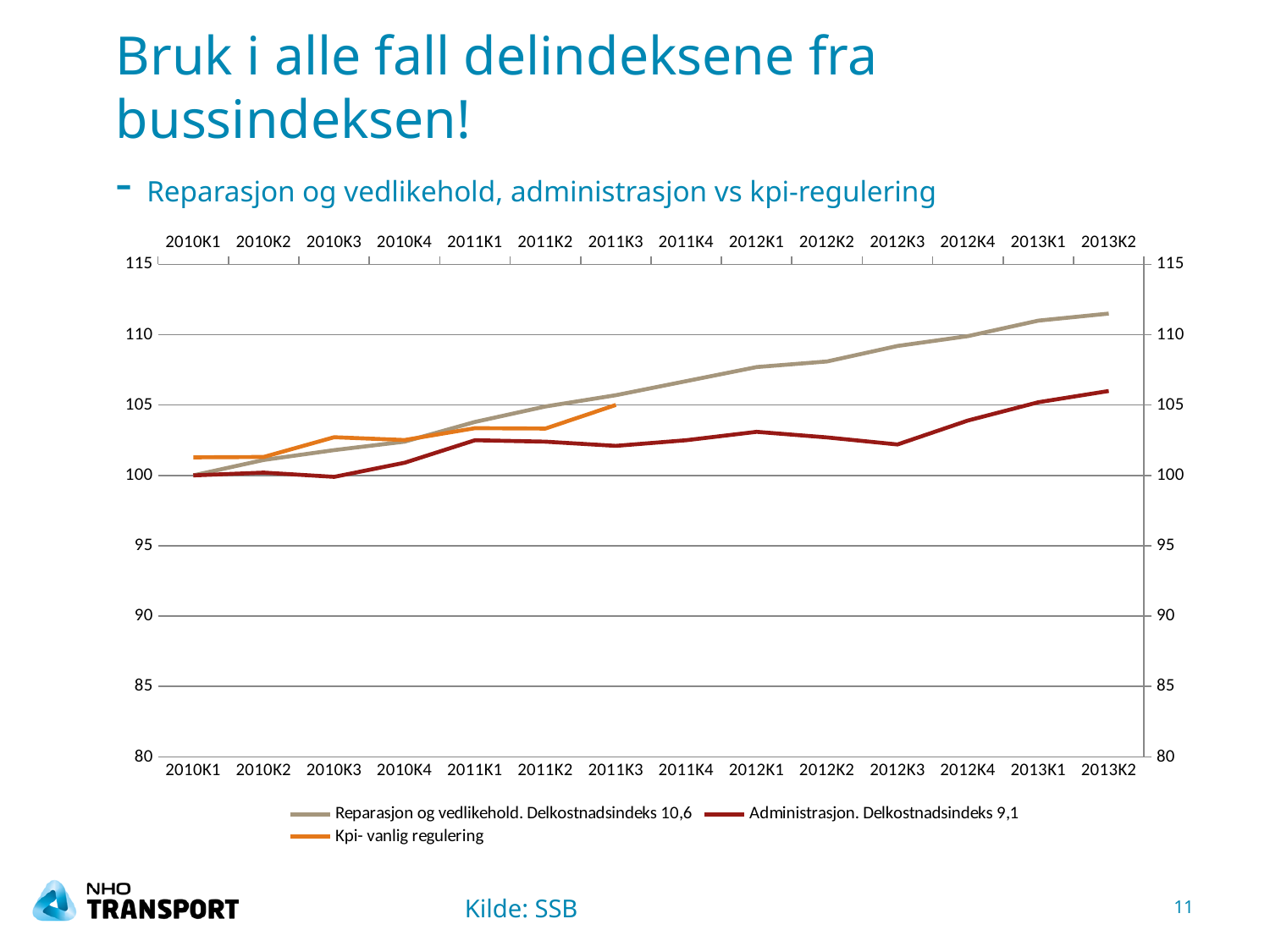
How many quarters are shown along the x axis? 14 Does the Reparasjon og vedlikehold series rise or fall from 2010K1 to 2013K2? rise Which series in the legend stops at 2011K3 instead of continuing to 2013K2? Kpi- vanlig regulering At 2010K3, which series is higher: Kpi- vanlig regulering or Administrasjon? Kpi- vanlig regulering Is the value for Administrasjon at 2012K3 greater or less than 105? less Is the value for Reparasjon og vedlikehold at 2012K1 greater or less than 105? greater At 2013K2, which series is higher: Reparasjon og vedlikehold or Administrasjon? Reparasjon og vedlikehold In which quarter does Reparasjon og vedlikehold reach its highest value? 2013K2 What kind of chart is shown on the slide? line chart Is the value for Kpi- vanlig regulering at 2010K3 greater or less than 100? greater How many series does the legend list? 3